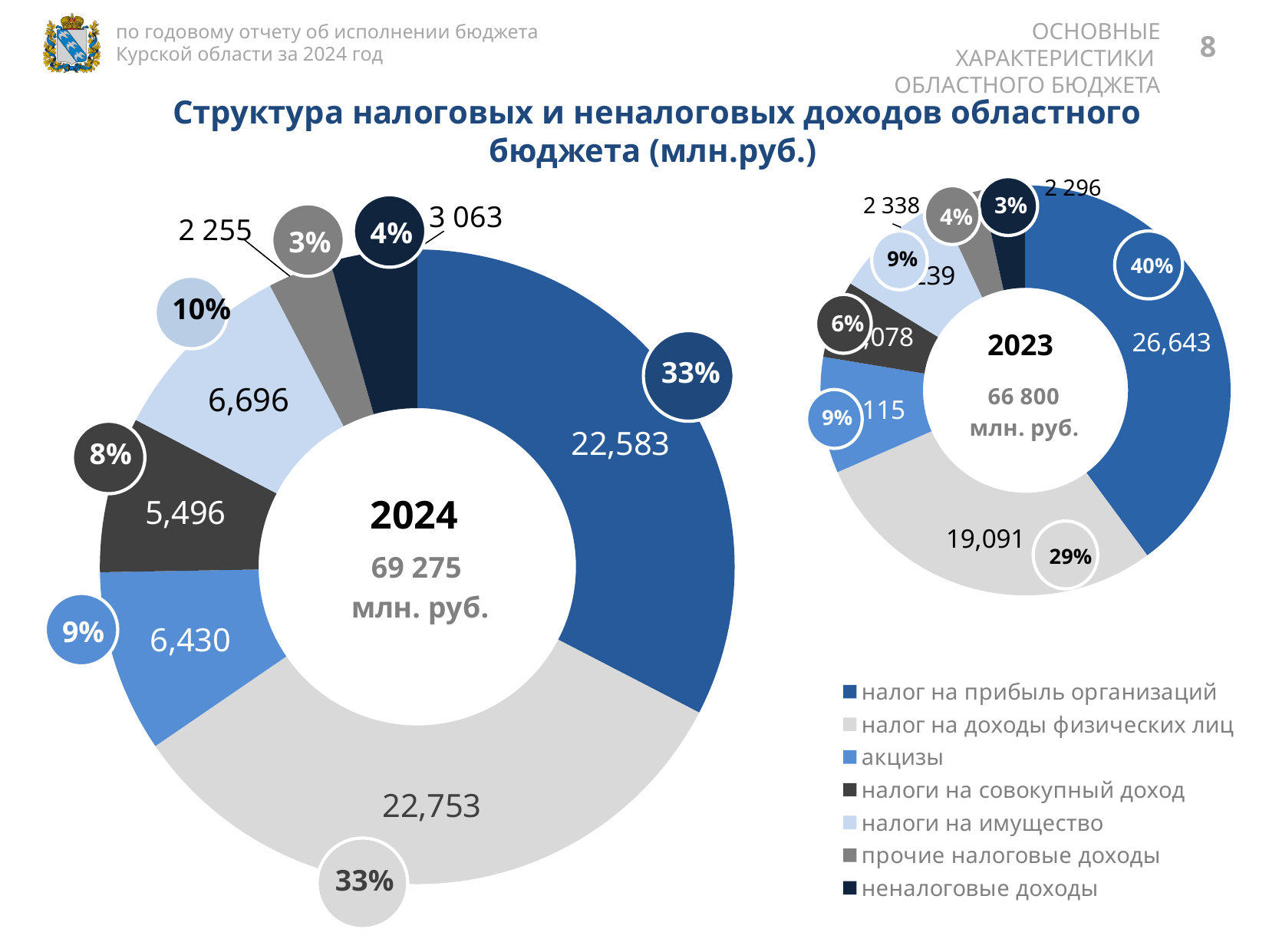
In the 2023 donut chart, which category has the largest value? налог на прибыль организаций In the 2024 donut chart, what is the value for налог на прибыль организаций? 22,583 In the 2024 donut chart, what share does налоги на совокупный доход have? 8% How many categories does the legend list? 7 In the 2024 donut chart, what is the difference between налоги на имущество and акцизы? 266 In the 2024 donut chart, what is the value for налог на доходы физических лиц? 22,753 In the 2023 donut chart, what share does налог на доходы физических лиц have? 29% In the 2024 donut chart, what is the value for налоги на имущество? 6,696 In the 2023 donut chart, what is the value for неналоговые доходы? 2 296 In the 2024 donut chart, what is the value for акцизы? 6,430 In the 2023 donut chart, what is the value for налог на прибыль организаций? 26,643 In the 2024 donut chart, which category has the smallest value? прочие налоговые доходы